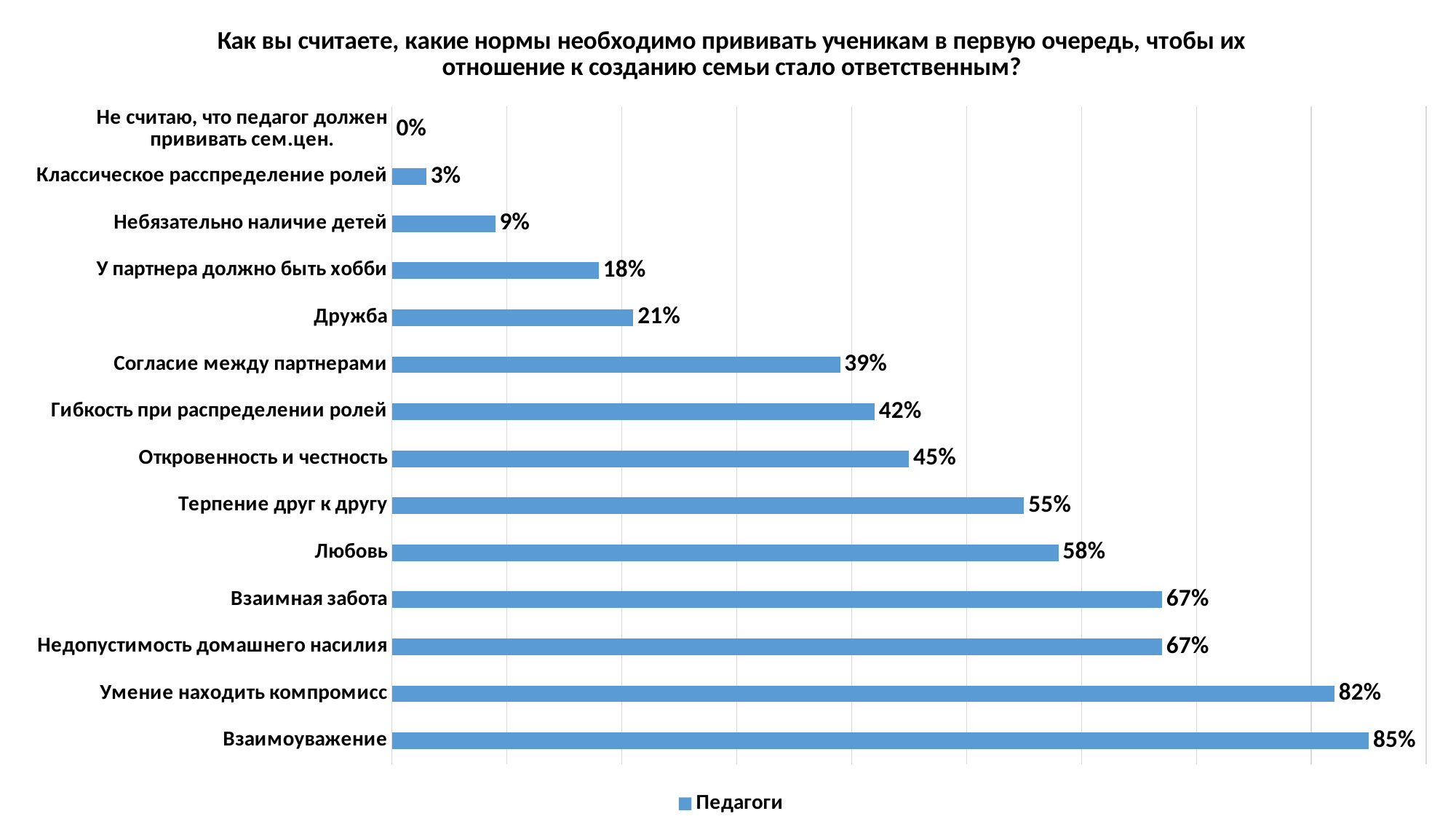
How many categories are shown in the chart? 14 What is the value for Дружба? 21% What is the difference between the values for Взаимоуважение and Умение находить компромисс? 3% What kind of chart is shown on the slide? Bar chart Which category has the lowest value? Не считаю, что педагог должен прививать сем.цен. What is the value for Взаимоуважение? 85% What is the value for Согласие между партнерами? 39% Which category has the highest value? Взаимоуважение Which is larger, the value for Любовь or the value for Терпение друг к другу? Любовь What is the name of the series shown in the legend? Педагоги How many series does the legend list? 1 What is the value for Умение находить компромисс? 82%